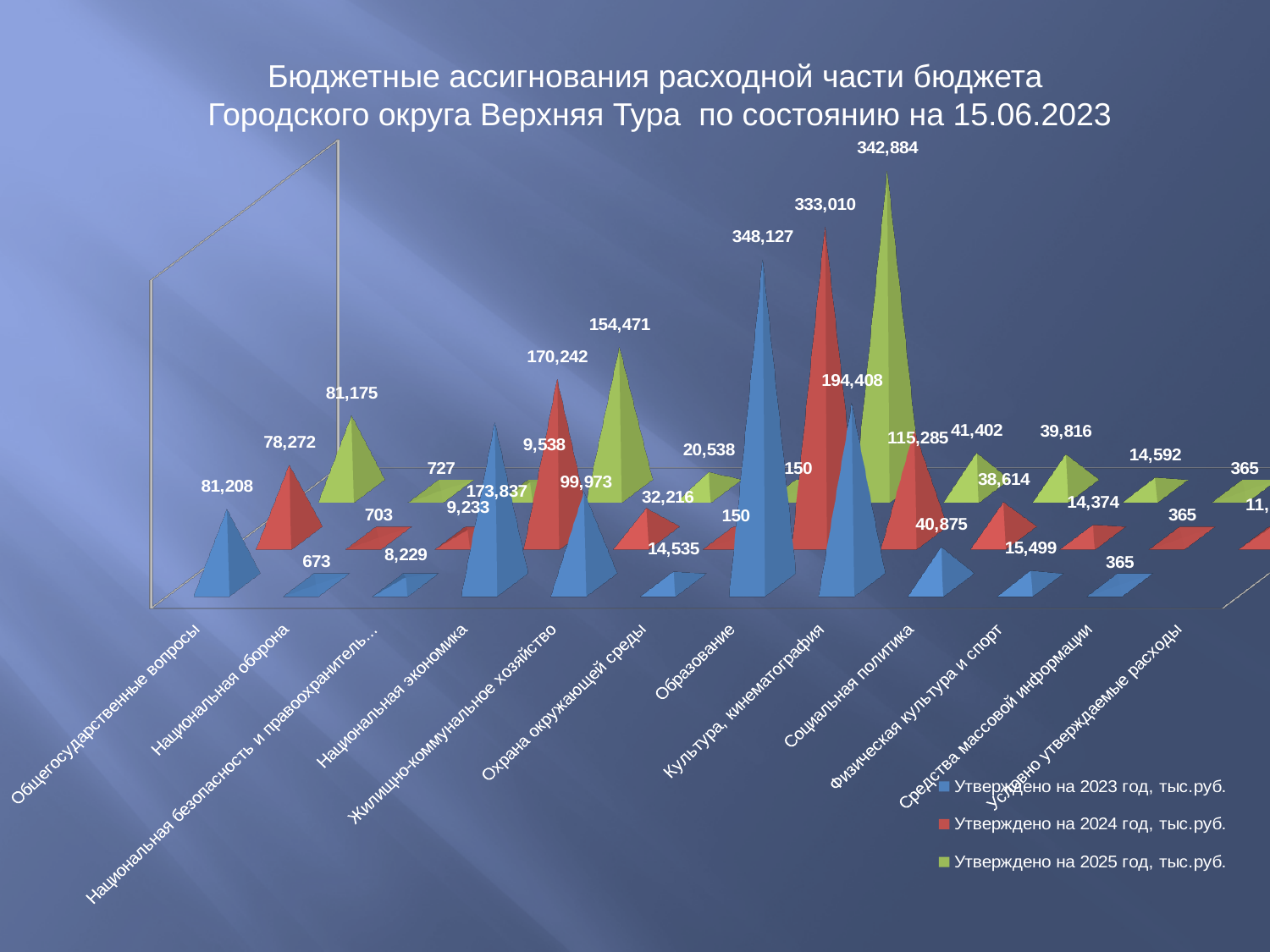
What is the value for Национальная оборона in the series 'Утверждено на 2025 год, тыс.руб.'? 727 How many expenditure categories are shown along the x axis? 12 Which colour represents the series 'Утверждено на 2025 год, тыс.руб.' in the legend? green Which is larger in the 2023 series: Национальная экономика or Культура, кинематография? Культура, кинематография What is the difference between the 2023 and 2024 values for Образование? 15,117 How many series does the legend list? 3 What is the difference between the 2023 and 2025 values for Культура, кинематография? 153,006 What is the value for Образование in the series 'Утверждено на 2023 год, тыс.руб.'? 348,127 What type of chart is shown on the slide? bar chart What is the value for Культура, кинематография in the series 'Утверждено на 2024 год, тыс.руб.'? 115,285 Which category has the highest value in the series 'Утверждено на 2023 год, тыс.руб.'? Образование What is the value for Средства массовой информации in the series 'Утверждено на 2023 год, тыс.руб.'? 365